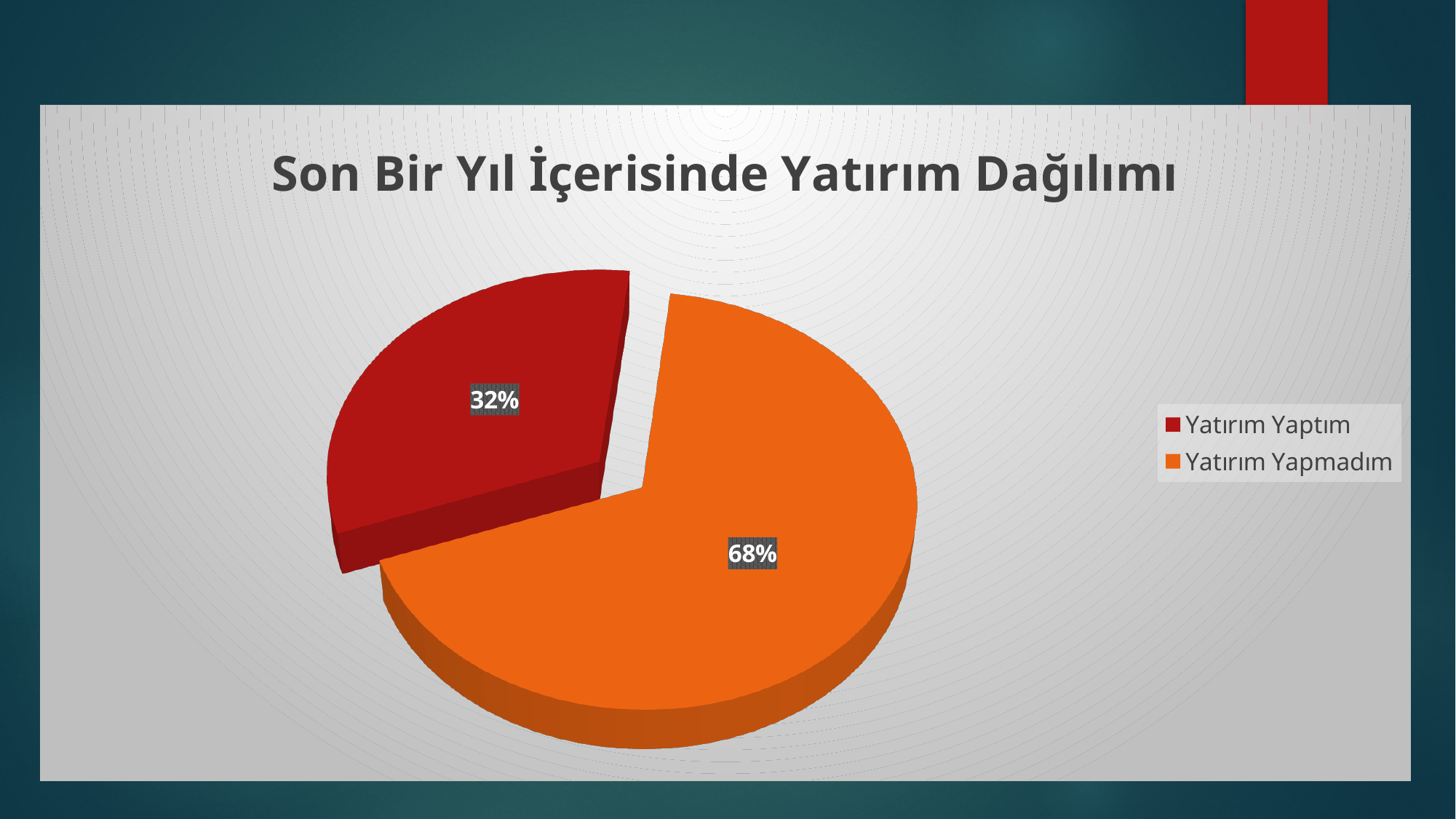
Which category has the largest slice of the pie? Yatırım Yapmadım What share of the pie does "Yatırım Yapmadım" represent? 68% Which category has the smallest slice of the pie? Yatırım Yaptım What colour is the slice for "Yatırım Yapmadım"? Orange What is the difference in percentage points between "Yatırım Yapmadım" and "Yatırım Yaptım"? 36 What share of the pie does "Yatırım Yaptım" represent? 32% Which is larger: the share for "Yatırım Yaptım" or the share for "Yatırım Yapmadım"? Yatırım Yapmadım What is the total of the two percentages shown on the pie chart? 100% What is the title of the chart? Son Bir Yıl İçerisinde Yatırım Dağılımı How many categories does the pie chart show? 2 What kind of chart is shown on the slide? Pie chart